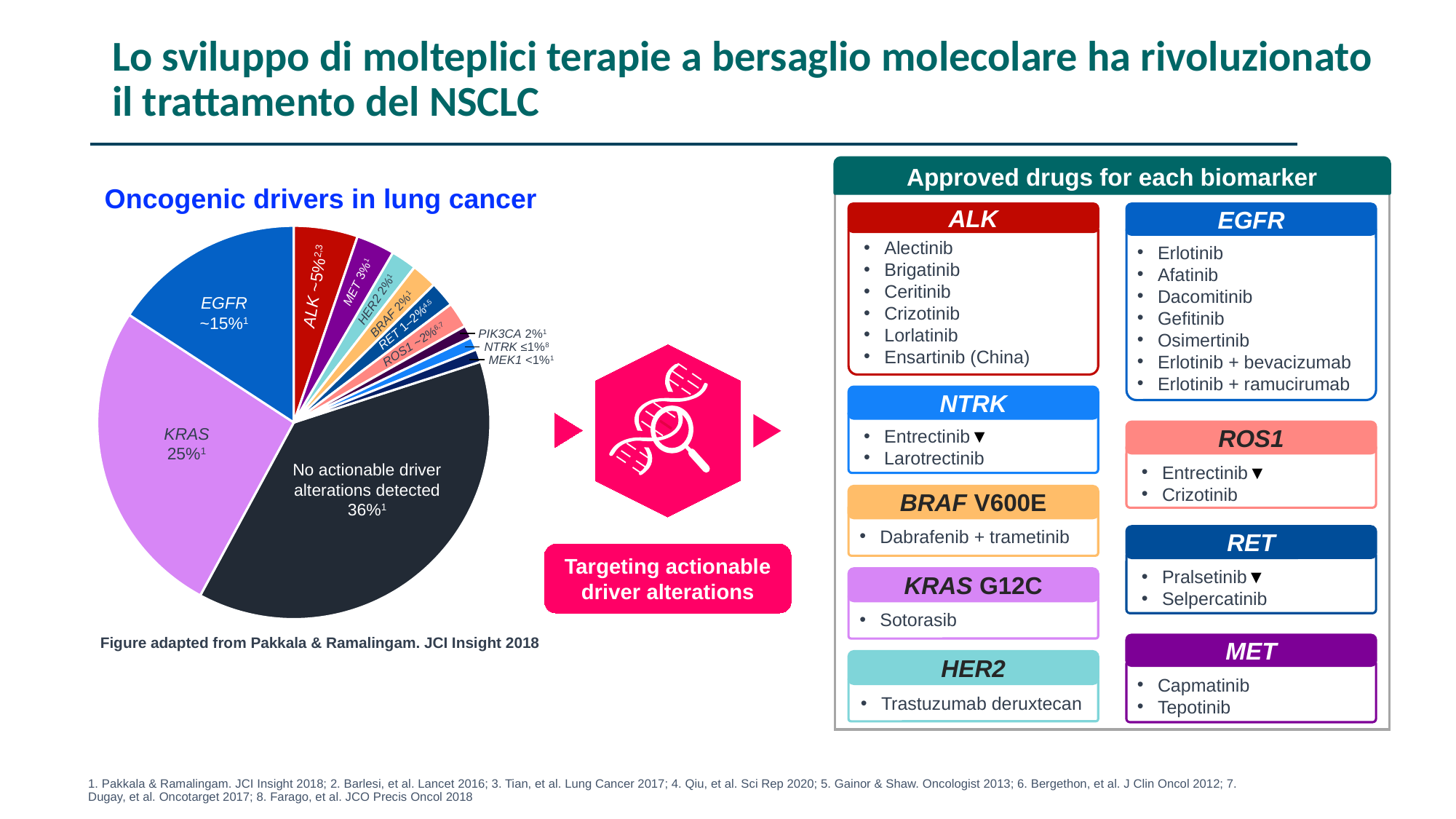
In the pie chart, what percentage is shown for MET? 3% How many slices does the pie chart have? 12 In the pie chart, what percentage is shown for KRAS? 25% Which slice of the pie chart is the largest? No actionable driver alterations detected In the pie chart, what percentage is shown for PIK3CA? 2% In the pie chart, what is the difference in percentage points between 'No actionable driver alterations detected' (36%) and KRAS (25%)? 11 percentage points In the pie chart, what percentage is shown for 'No actionable driver alterations detected'? 36% In the pie chart, what value is printed for EGFR? ~15% According to the caption, from which publication is the pie chart figure adapted? Pakkala & Ramalingam. JCI Insight 2018 What kind of chart is shown under the heading 'Oncogenic drivers in lung cancer'? Pie chart What is the title of the pie chart? Oncogenic drivers in lung cancer In the pie chart, which is larger: the KRAS slice or the EGFR slice? KRAS